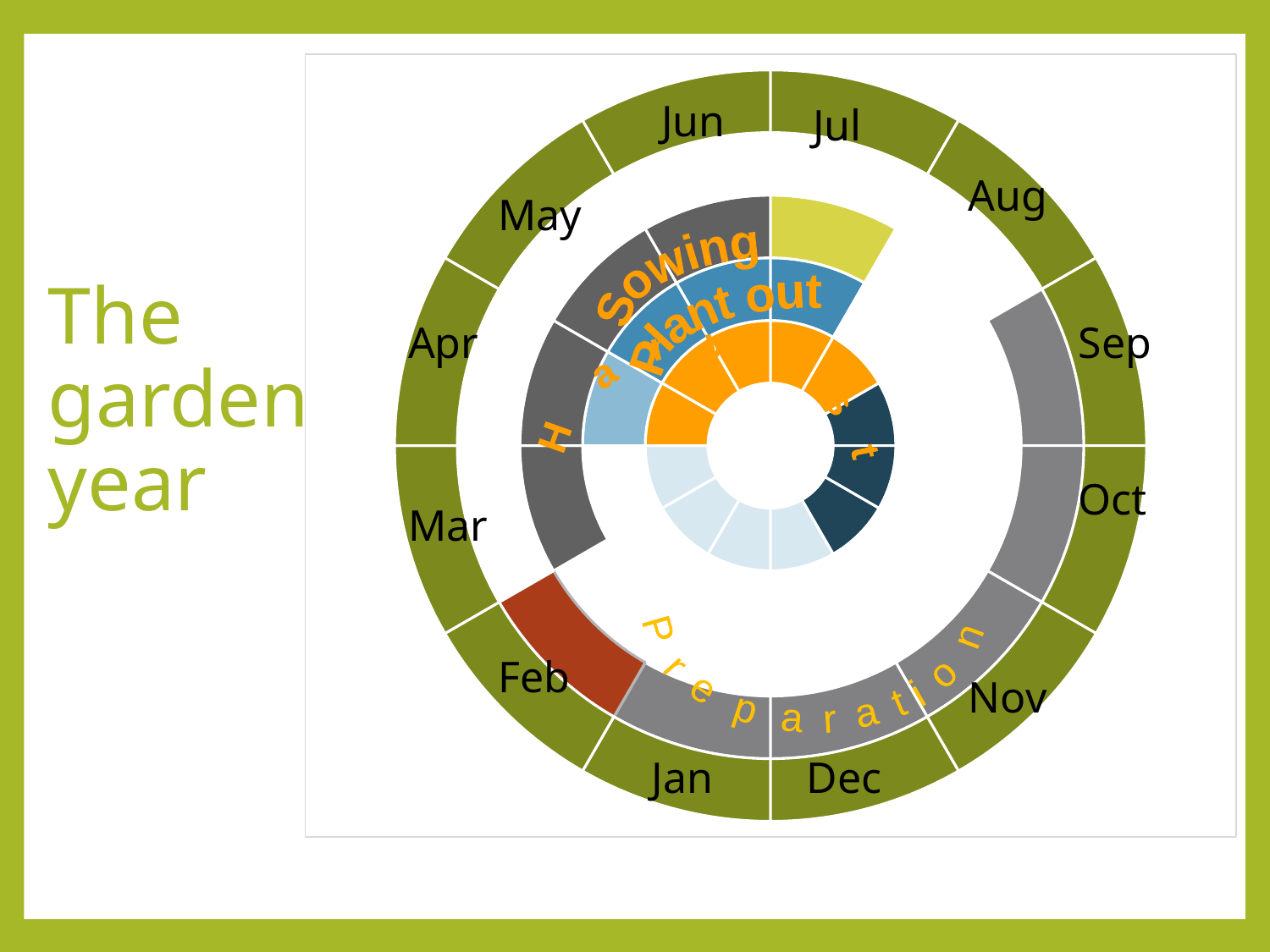
Which month segment on the outer ring is coloured dark red instead of green? Feb What kind of chart is shown on the slide? doughnut chart What is the title of the slide containing the chart? The garden year Which activity label runs along the grey ring between Nov and Jan? Preparation How many month segments are there on the outer ring of the chart? 12